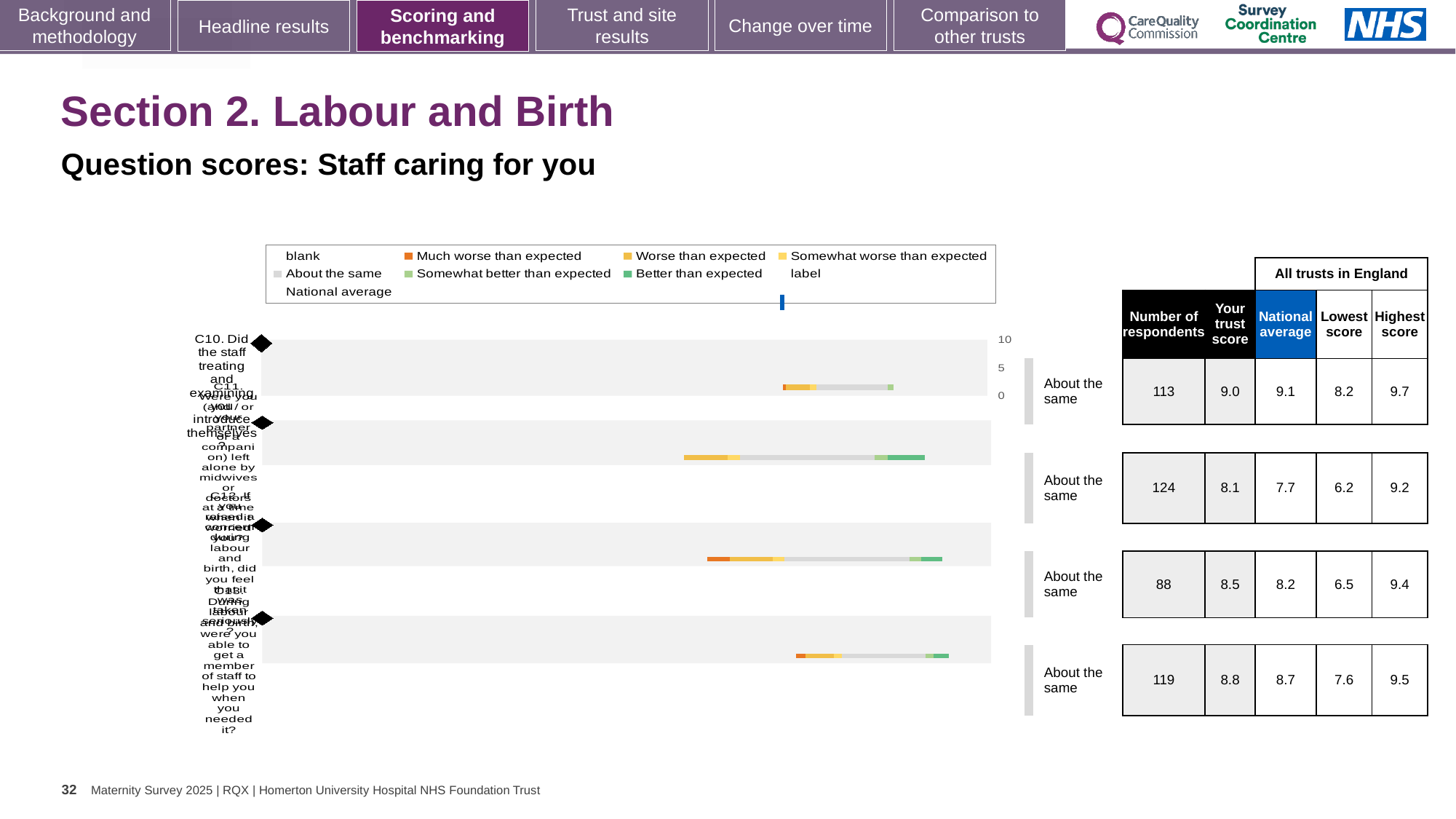
Is the trust score for the fourth row (C13) larger or smaller than its national average? larger What is the number of respondents for the first row (C10)? 113 What is the trust score for the second row (C11)? 8.1 Which row has the lowest number of respondents? C12 (third row), 88 Which row has the highest trust score? C10 (first row), 9.0 What kind of chart is shown on the slide? bar chart How many benchmark categories from 'Much worse than expected' to 'Better than expected' does the legend list? 6 What is the highest score among all trusts in England for the fourth row (C13)? 9.5 What is the national average for the third row (C12)? 8.2 What benchmark category is shown for each of the four rows? About the same How many question rows (bars) does the chart show? 4 What is the difference between the trust score and the national average for the second row (C11)? 0.4